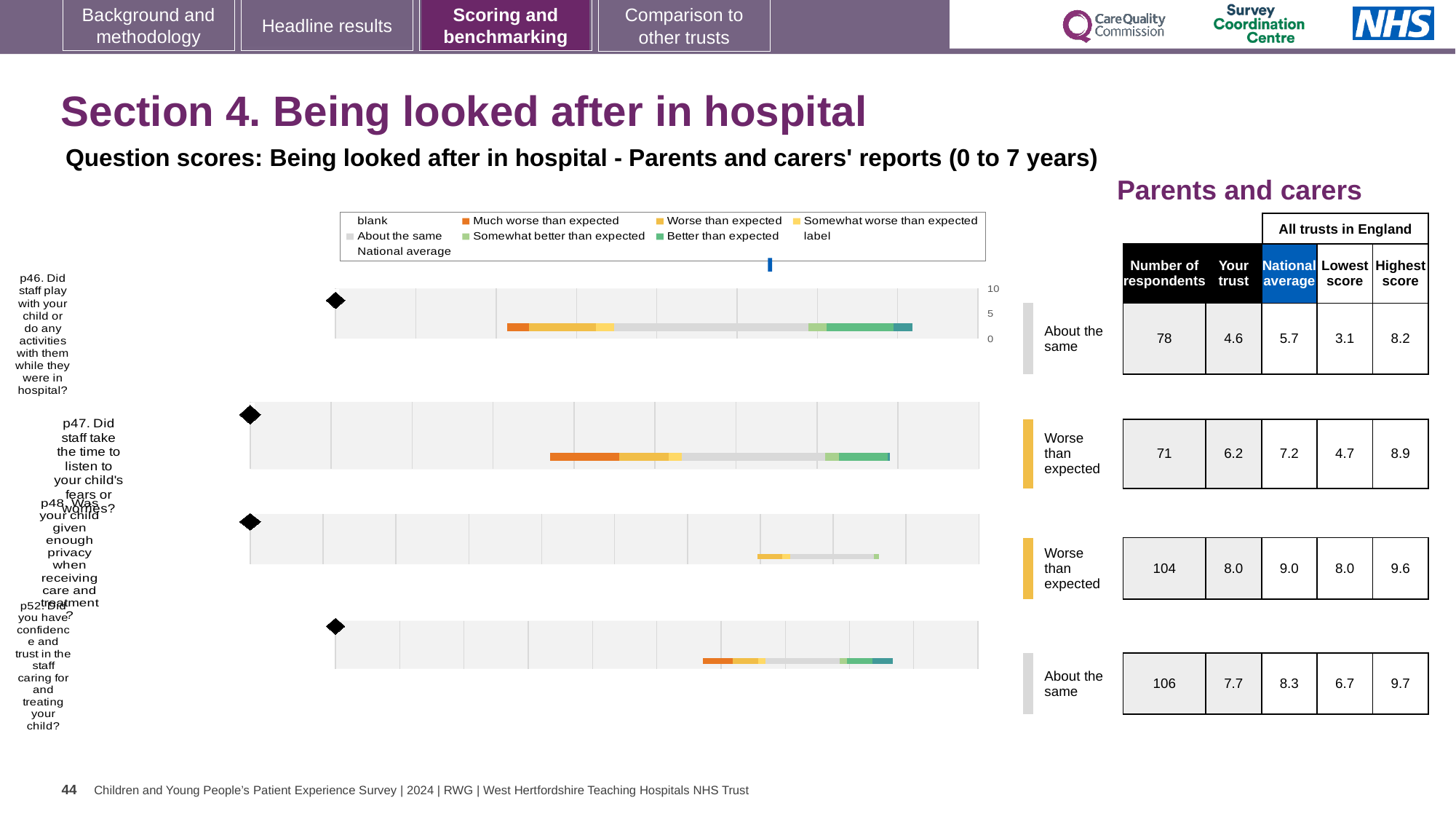
For p47, which is larger: the 'Your trust' score or the national average? National average For p52, what is the difference between the highest score and the lowest score among all trusts in England? 3.0 What kind of chart is used to show the question scores on this slide? bar chart For p46, how much higher is the national average than the 'Your trust' score? 1.1 For p52 (Did you have confidence and trust in the staff caring for and treating your child?), what is the highest score among all trusts in England? 9.7 For p47 (Did staff take the time to listen to your child's fears or worries?), what is the national average score? 7.2 What benchmark category is shown for p48 (Was your child given enough privacy when receiving care and treatment?)? Worse than expected How many respondents answered p48 (Was your child given enough privacy when receiving care and treatment?)? 104 For p46 (Did staff play with your child or do any activities with them while they were in hospital?), what is the 'Your trust' score? 4.6 Which question has the lowest 'Your trust' score? p46 Which question has the highest 'Your trust' score? p48 How many survey questions (chart rows) are shown on the slide? 4